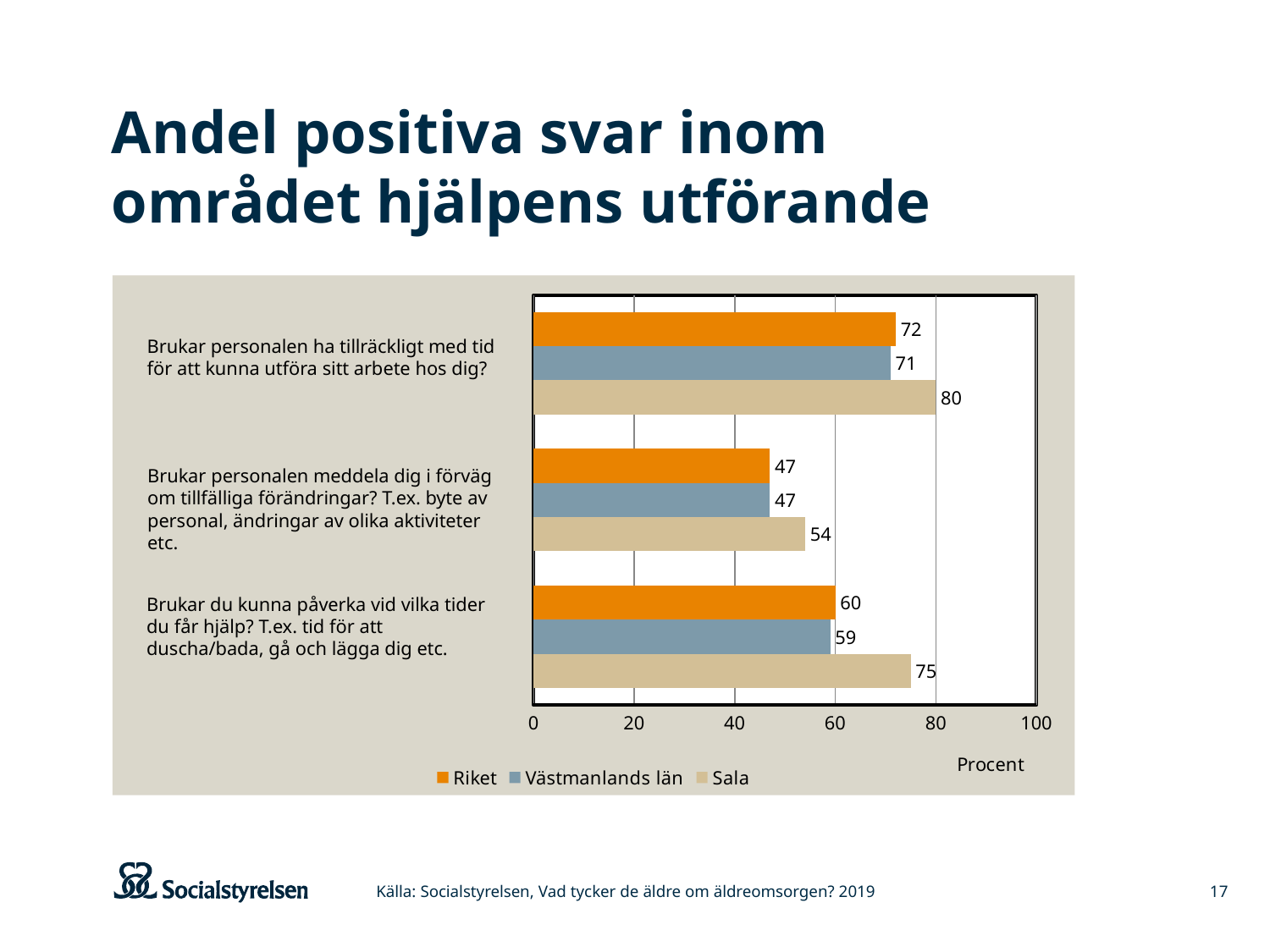
What unit label is shown on the x axis of the chart? Procent Which is larger on the question "Brukar personalen ha tillräckligt med tid för att kunna utföra sitt arbete hos dig?": Riket or Västmanlands län? Riket How many series does the legend list? 3 Which question has the lowest value for Sala? Brukar personalen meddela dig i förväg om tillfälliga förändringar? Is the value for Sala on the question "Brukar personalen meddela dig i förväg om tillfälliga förändringar?" greater or less than 60? less What kind of chart is shown on the slide? Bar chart What is the value for Västmanlands län on the question "Brukar du kunna påverka vid vilka tider du får hjälp?"? 59 What is the difference between the Sala value and the Riket value on the question "Brukar du kunna påverka vid vilka tider du får hjälp?"? 15 What is the value for Riket on the question "Brukar personalen meddela dig i förväg om tillfälliga förändringar?"? 47 How many questions (categories) are shown in the chart? 3 What is the value for Sala on the question "Brukar personalen ha tillräckligt med tid för att kunna utföra sitt arbete hos dig?"? 80 Which series has the highest value on the question "Brukar du kunna påverka vid vilka tider du får hjälp?"? Sala